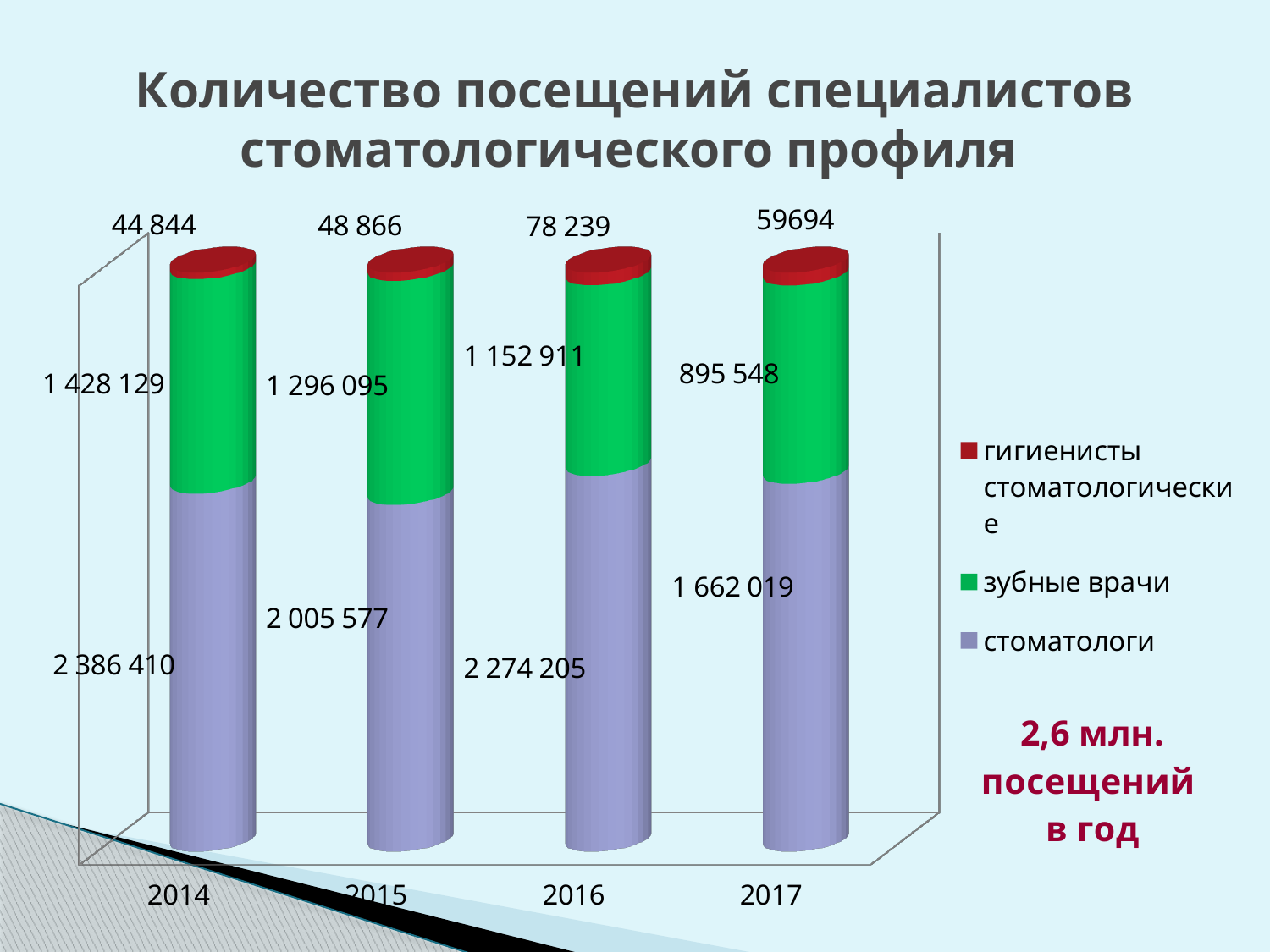
How many years are shown on the x axis? 4 What is the difference between the зубные врачи values for 2016 and 2017? 257 363 In which year is the value for гигиенисты стоматологические the highest? 2016 In which year is the value for стоматологи the lowest? 2017 How many series does the legend list? 3 Which is larger: the стоматологи value for 2015 or for 2016? 2016 What is the value for гигиенисты стоматологические in 2015? 48 866 What kind of chart is shown on the slide? Stacked bar chart What is the difference between the стоматологи values for 2014 and 2015? 380 833 What is the value for стоматологи in 2014? 2 386 410 Do the values for зубные врачи rise or fall from 2014 to 2017? Fall What is the value for зубные врачи in 2017? 895 548